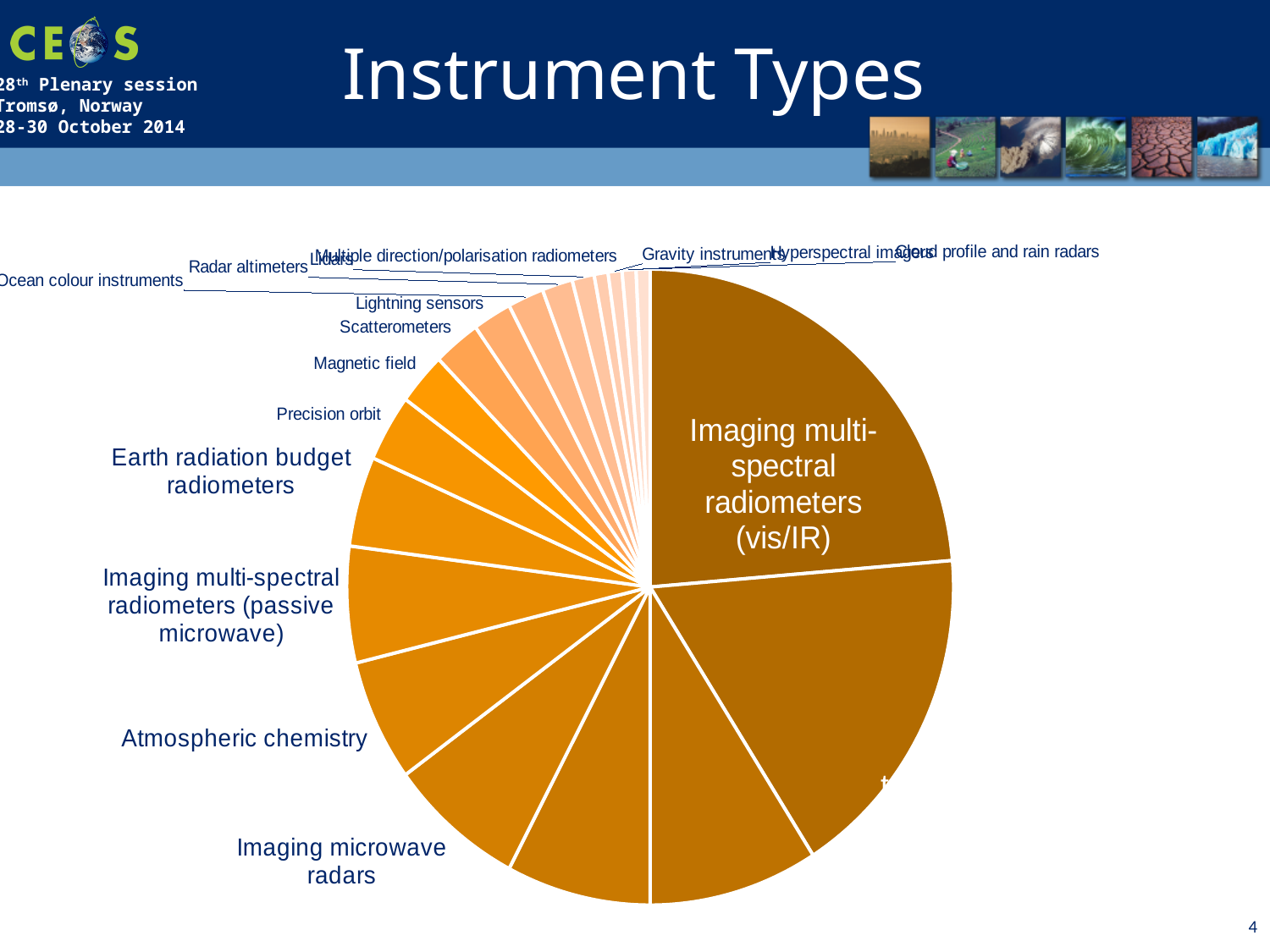
Which instrument type has the largest slice of the pie? Imaging multi-spectral radiometers (vis/IR) Is the share of the pie for Imaging multi-spectral radiometers (vis/IR) greater or less than 50%? less What is the title of the slide containing the pie chart? Instrument Types Which slice is larger: Imaging microwave radars or Lightning sensors? Imaging microwave radars Which slice is larger: Precision orbit or Gravity instruments? Precision orbit Which slice is larger: Imaging multi-spectral radiometers (vis/IR) or Atmospheric chemistry? Imaging multi-spectral radiometers (vis/IR) What kind of chart is shown on the slide? pie chart Is the share of the pie for Imaging multi-spectral radiometers (vis/IR) greater or less than 10%? greater